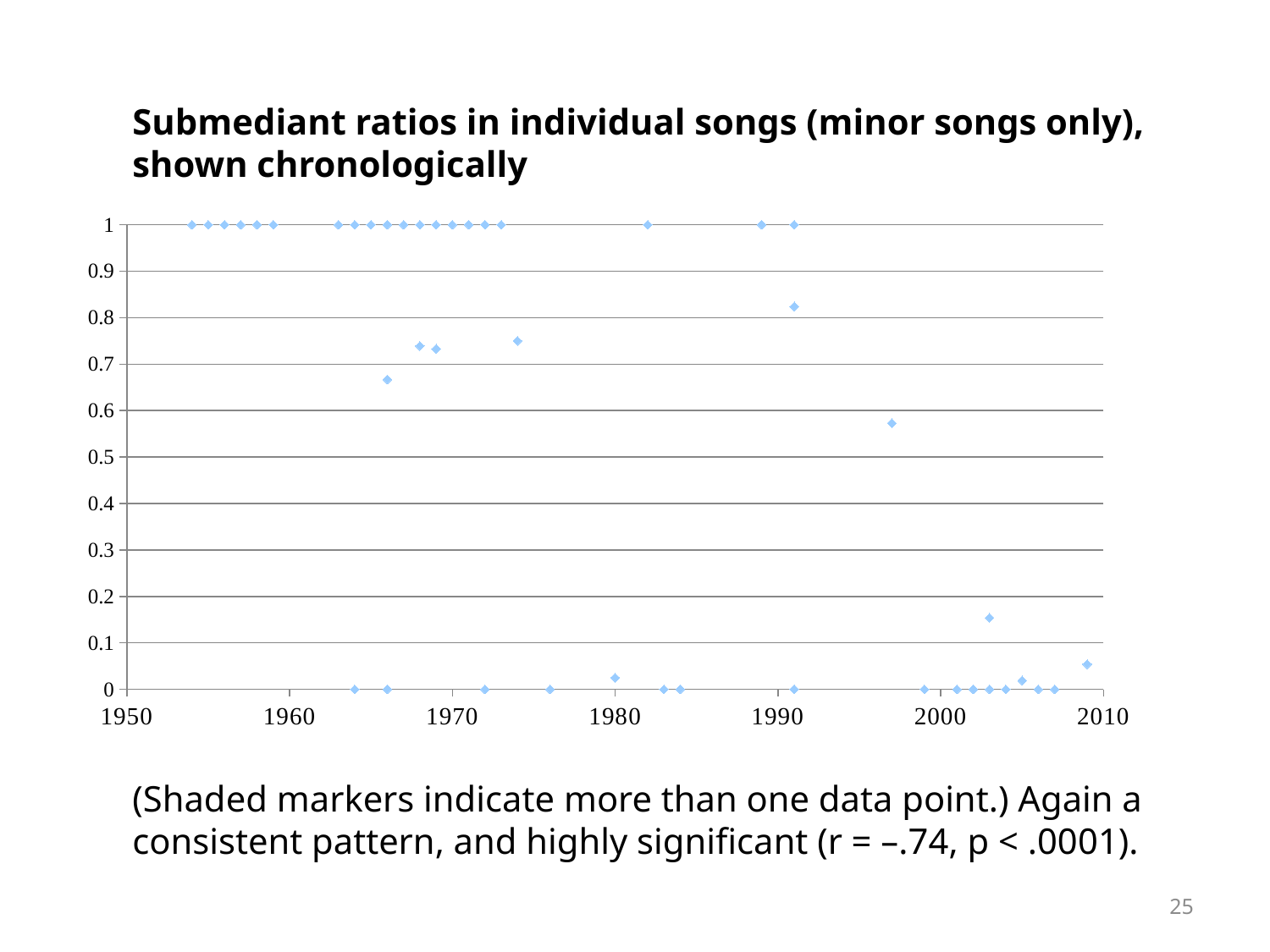
Is the value for the song plotted around 1997 greater or less than 0.5? greater Is the value for the song plotted around 1966 (the one above the zero line) greater or less than 0.6? greater What is the title of the chart? Submediant ratios in individual songs (minor songs only), shown chronologically What is the submediant ratio for the song plotted at 1976? 0 Which is larger: the value for the song plotted around 1997 or the value for the song plotted around 2009? 1997 Is the value for the song plotted around 2003 (the one above the zero line) greater or less than 0.2? less What is the lowest submediant ratio value plotted on the chart? 0 What kind of chart is shown on the slide? scatter chart What is the submediant ratio for the song plotted at 1982? 1 What is the highest value shown on the vertical axis? 1 Overall, do the submediant ratios rise or fall as the years increase along the x axis? fall What is the highest submediant ratio value plotted on the chart? 1